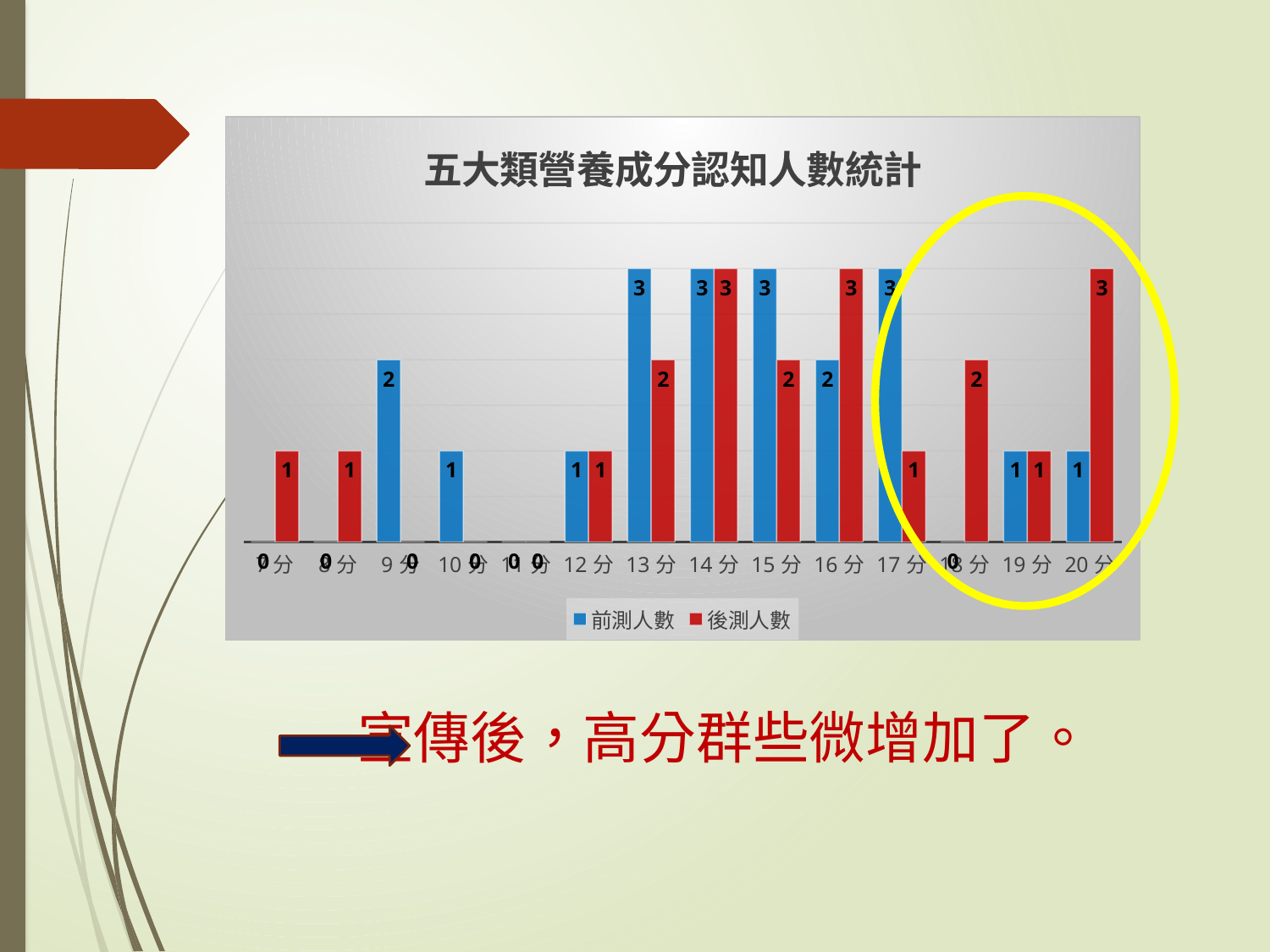
What is the 後測人數 value for 18 分? 2 Among 18 分, 19 分 and 20 分, which has the highest 後測人數? 20 分 What is the difference between 後測人數 and 前測人數 for 20 分? 2 What is the title of the chart? 五大類營養成分認知人數統計 What is the 前測人數 value for 17 分? 3 For 16 分, which is larger, 前測人數 or 後測人數? 後測人數 What is the 後測人數 value for 20 分? 3 For 17 分, which is larger, 前測人數 or 後測人數? 前測人數 How many series does the legend list? 2 Which series is shown in red in the legend? 後測人數 What is the 前測人數 value for 9 分? 2 What type of chart is shown on the slide? bar chart